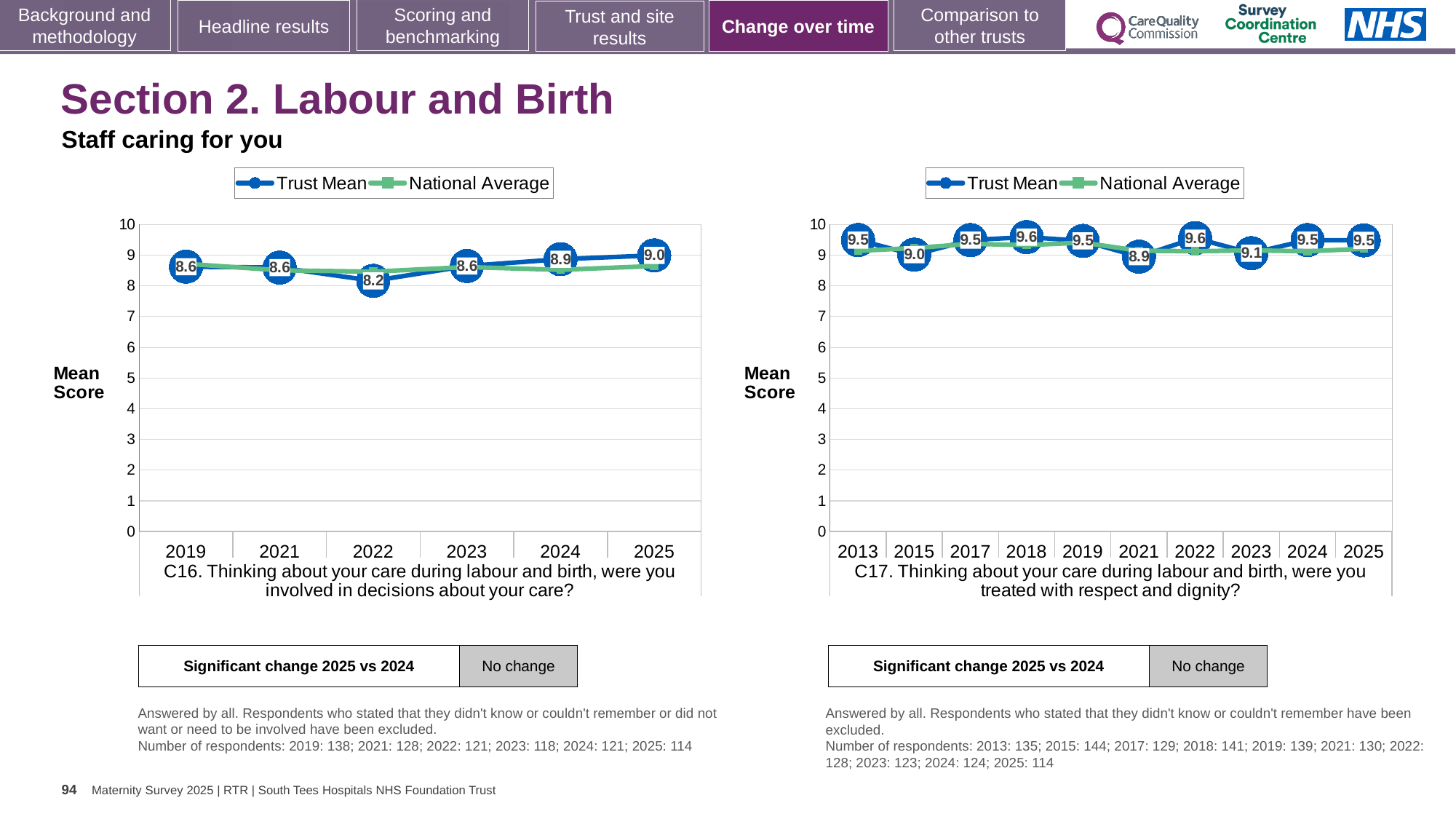
In the C17 chart (right), how many years are shown on the x axis? 10 In the C16 chart (left), what is the difference between the Trust Mean scores for 2025 and 2022? 0.8 How many series does the legend of the C17 chart (right) list? 2 In the C16 chart (left), how many years are shown on the x axis? 6 In the C17 chart (right), what is the Trust Mean score for 2021? 8.9 In the C17 chart (right), what is the Trust Mean score for 2018? 9.6 In the C16 chart (left), what is the Trust Mean score for 2022? 8.2 In the C17 chart (right), is the Trust Mean score for 2015 larger or smaller than the score for 2017? smaller In the C16 chart (left), which year has the highest Trust Mean score? 2025 In the C17 chart (right), which year has the lowest Trust Mean score? 2021 In the C16 chart (left), what is the Trust Mean score for 2025? 9.0 In the C16 chart (left), which year has the lowest Trust Mean score? 2022